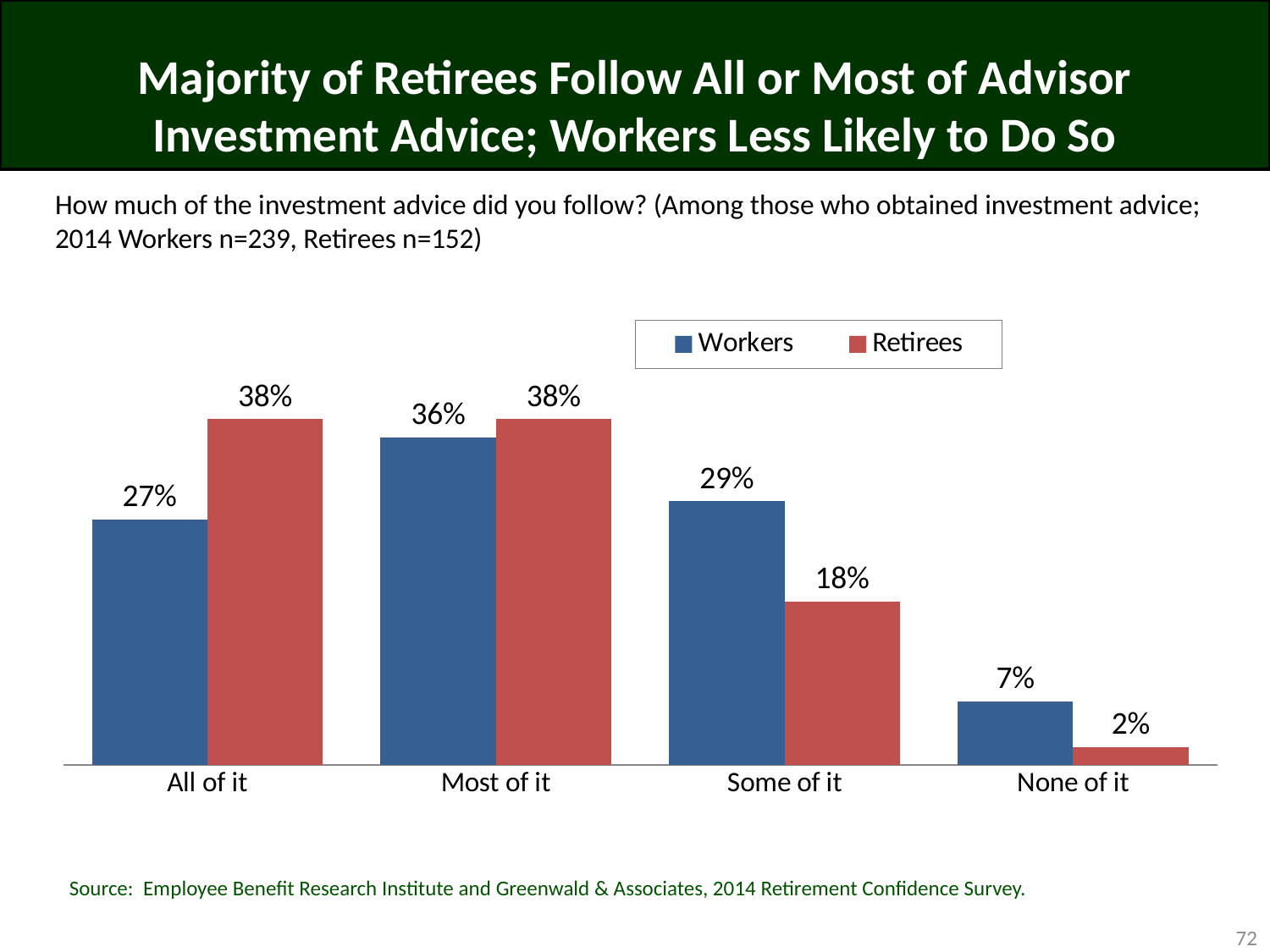
What percentage of Retirees followed none of the investment advice? 2% Which category has the lowest value for Retirees? None of it What kind of chart is shown on the slide? Bar chart Which group has the larger value for 'None of it', Workers or Retirees? Workers What percentage of Workers followed all of the investment advice? 27% How many series does the legend list? 2 What is the difference between Workers and Retirees for 'Some of it'? 11% What percentage of Retirees followed most of the investment advice? 38% Which category has the highest value for Workers? Most of it Which group has the larger value for 'All of it', Workers or Retirees? Retirees What is the difference between Retirees and Workers for 'All of it'? 11% How many categories are shown on the x axis? 4